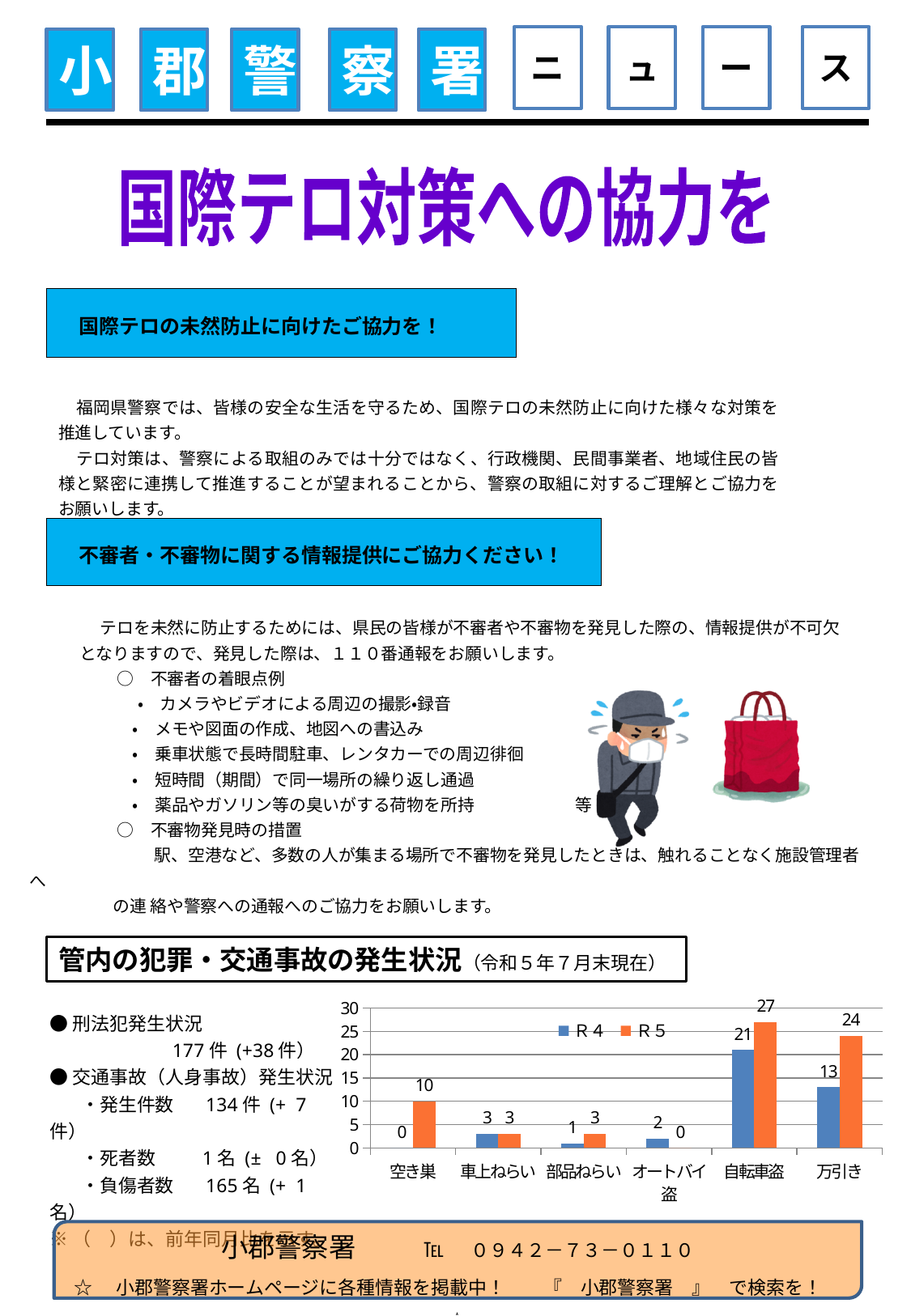
How many categories are shown on the x axis of the chart? 6 What is the R4 value for 万引き in the chart? 13 What type of chart is shown on the slide? bar chart Which category has the lowest R4 value in the chart? 空き巣 What is the R4 value for オートバイ盗 in the chart? 2 What is the R5 value for 空き巣 in the chart? 10 Which category has the highest R5 value in the chart? 自転車盗 What are the two series names in the chart legend? R4 and R5 Which is larger for 部品ねらい, the R4 value or the R5 value? R5 What is the R5 value for 自転車盗 in the chart? 27 What is the difference between the R5 and R4 values for 万引き? 11 How many series does the chart legend list? 2